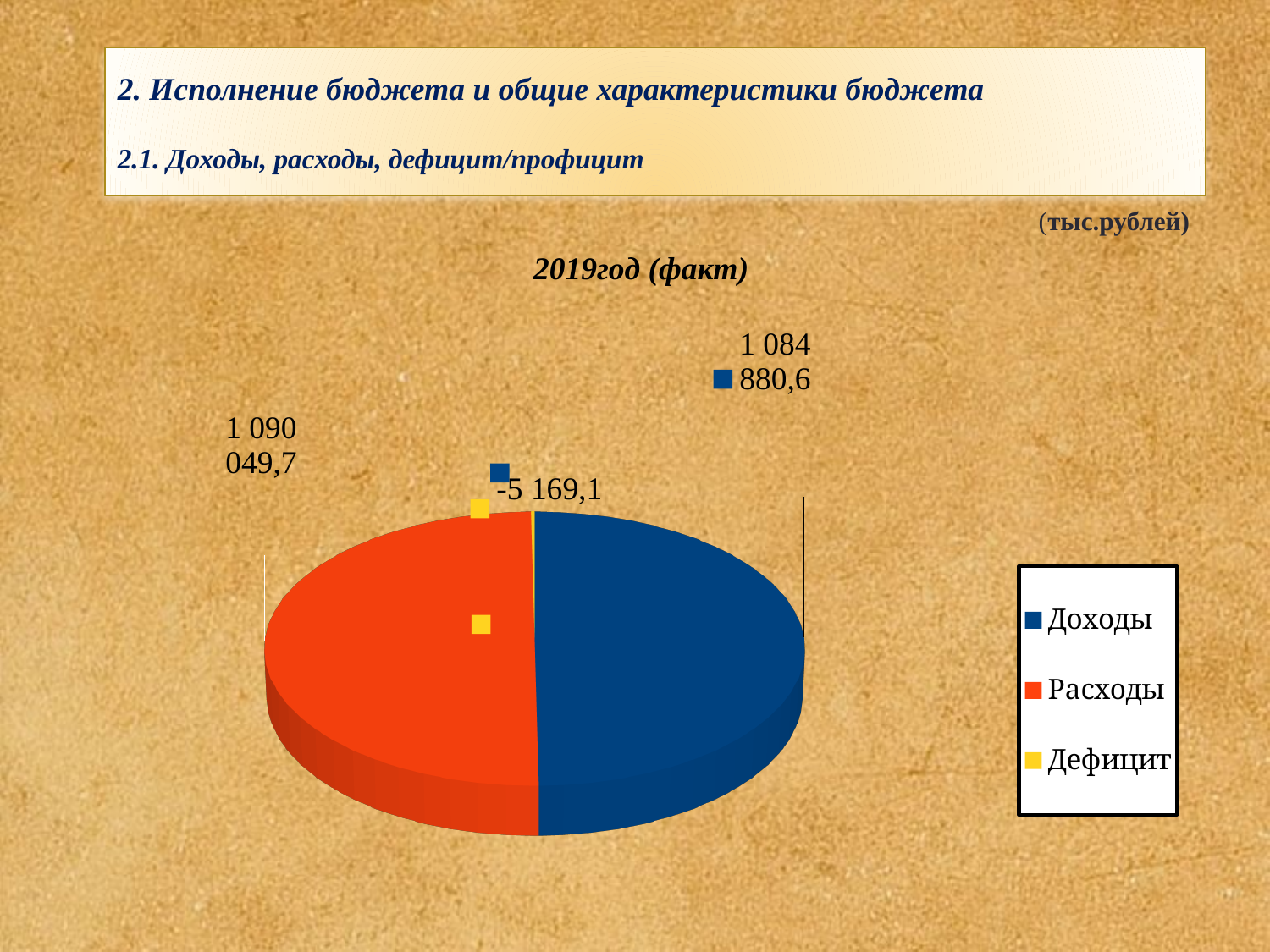
What is the value for Расходы? 1 090 049,7 What is the title of the chart? 2019год (факт) What is the difference between Расходы and Доходы? 5 169,1 Which category has the lowest value? Дефицит How many categories does the pie chart show? 3 What type of chart is shown on the slide? Pie chart What colour represents Расходы in the chart? Red How many entries does the legend list? 3 Which is larger, Доходы or Расходы? Расходы What is the value for Дефицит? -5 169,1 Which category has the highest value? Расходы What is the value for Доходы? 1 084 880,6